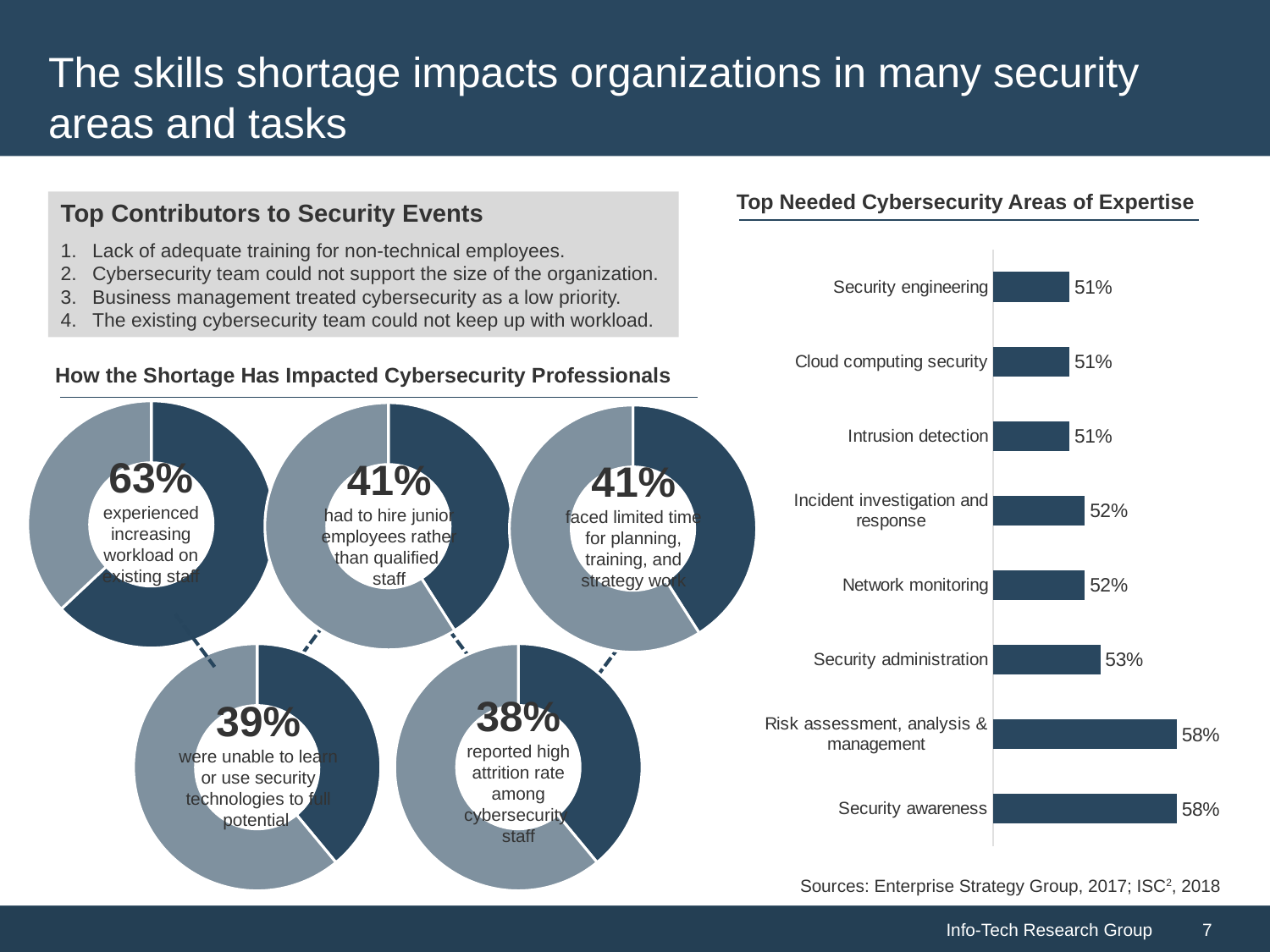
In the 'Top Needed Cybersecurity Areas of Expertise' chart, which is larger: Security administration or Cloud computing security? Security administration In the 'Top Needed Cybersecurity Areas of Expertise' chart, what is the value for Intrusion detection? 51% How many donut charts are shown in the 'How the Shortage Has Impacted Cybersecurity Professionals' section? 5 What kind of chart is 'Top Needed Cybersecurity Areas of Expertise'? Bar chart In the 'How the Shortage Has Impacted Cybersecurity Professionals' section, what percentage experienced increasing workload on existing staff? 63% In the 'Top Needed Cybersecurity Areas of Expertise' chart, how many areas of expertise are listed? 8 In the 'How the Shortage Has Impacted Cybersecurity Professionals' section, which impact has the highest percentage? Experienced increasing workload on existing staff (63%) In the 'Top Needed Cybersecurity Areas of Expertise' chart, what is the value for Security awareness? 58% In the 'Top Needed Cybersecurity Areas of Expertise' chart, what is the difference between Security awareness and Network monitoring? 6 percentage points In the 'Top Needed Cybersecurity Areas of Expertise' chart, what is the value for Security administration? 53% In the 'Top Needed Cybersecurity Areas of Expertise' chart, what is the value for Network monitoring? 52% In the 'How the Shortage Has Impacted Cybersecurity Professionals' section, what percentage reported high attrition rate among cybersecurity staff? 38%